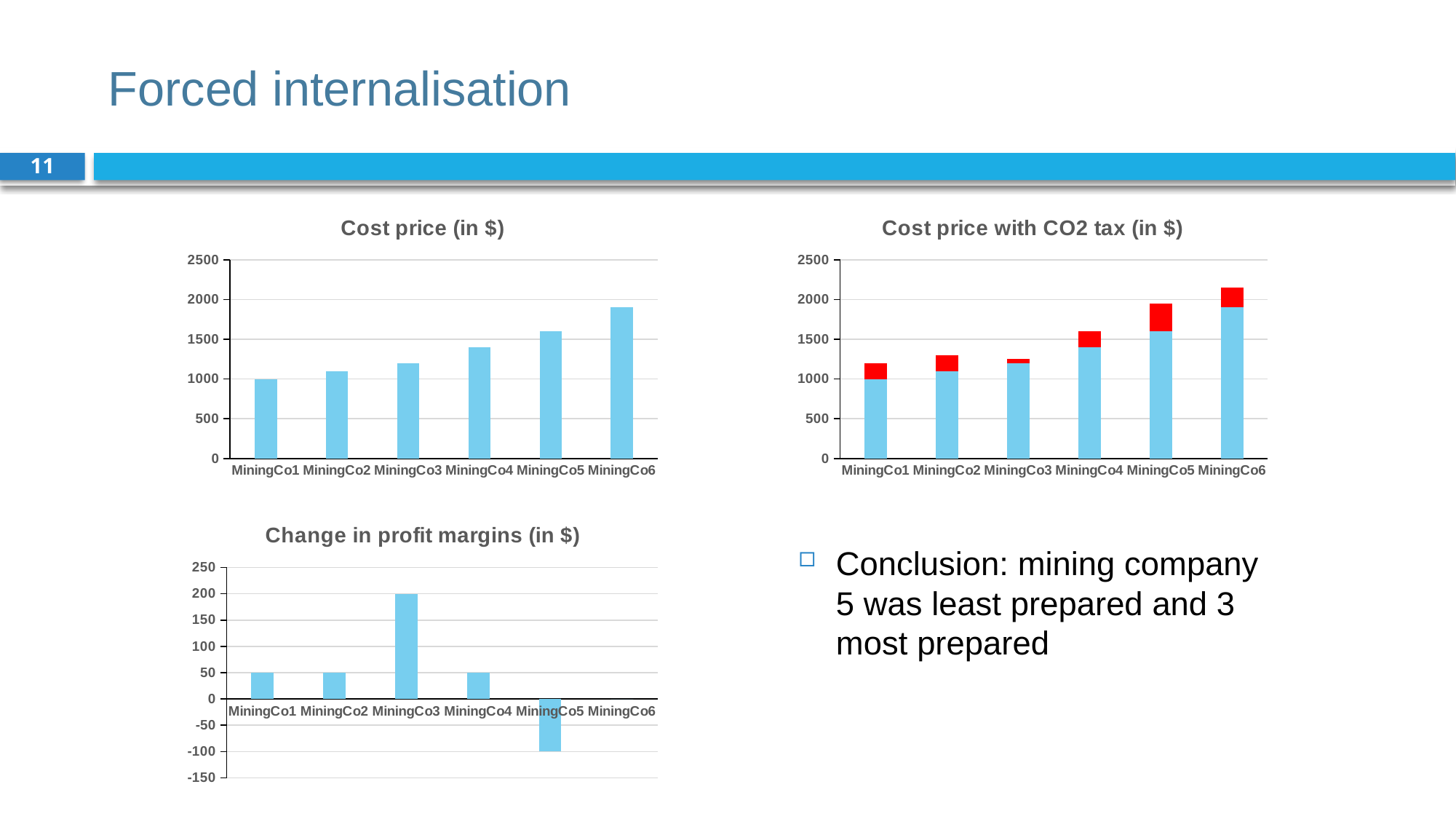
In the 'Cost price with CO2 tax (in $)' chart, which company has the smallest red (CO2 tax) segment? MiningCo3 In the 'Change in profit margins (in $)' chart, what is the value for MiningCo3? 200 In the 'Cost price (in $)' chart, which company has the lowest cost price? MiningCo1 In the 'Change in profit margins (in $)' chart, what is the difference between the values for MiningCo3 and MiningCo1? 150 In the 'Change in profit margins (in $)' chart, what is the value for MiningCo5? -100 How many companies are shown in the 'Cost price with CO2 tax (in $)' chart? 6 In the 'Cost price (in $)' chart, is the value for MiningCo5 greater or less than 1500? greater What type of chart is 'Change in profit margins (in $)'? bar chart In the 'Cost price (in $)' chart, which company has the highest cost price? MiningCo6 In the 'Cost price (in $)' chart, do the values rise or fall from MiningCo1 to MiningCo6? rise In the 'Cost price (in $)' chart, what is the value for MiningCo1? 1000 In the 'Cost price with CO2 tax (in $)' chart, is the total for MiningCo6 greater or less than 2000? greater